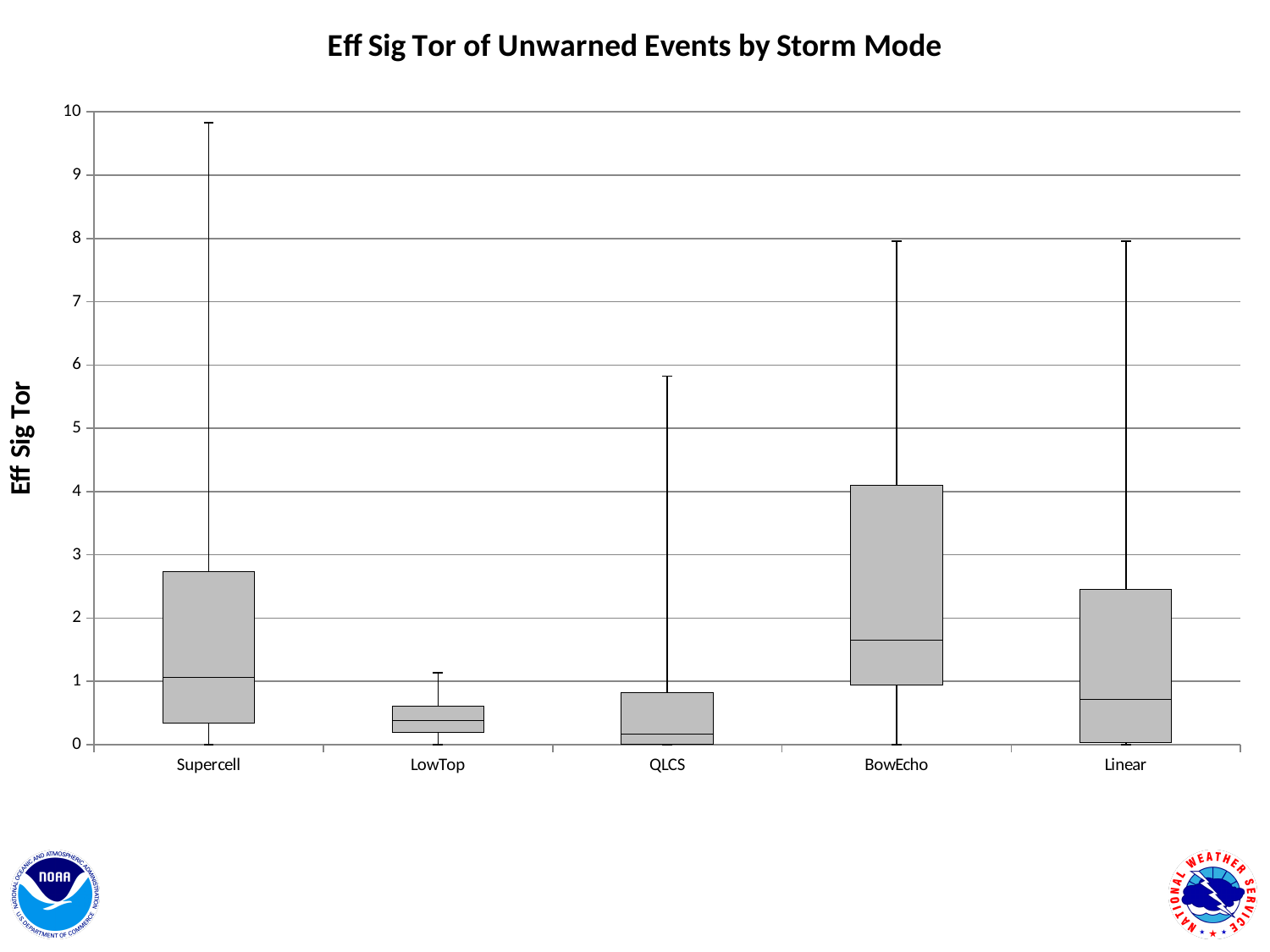
Which storm mode has the lowest upper whisker (maximum value)? LowTop Is the upper whisker for QLCS greater or less than 6? less Which storm mode has the highest median line? BowEcho Which storm mode has the highest upper whisker (maximum value)? Supercell What is the label on the y axis? Eff Sig Tor How many storm mode categories are shown on the x axis? 5 Is the top of the box for Linear greater or less than 3? less Is the upper whisker for LowTop greater or less than 2? less What is the title of the chart? Eff Sig Tor of Unwarned Events by Storm Mode What kind of chart is shown on the slide? Box plot (box-and-whisker chart) Which has the higher median, BowEcho or Linear? BowEcho